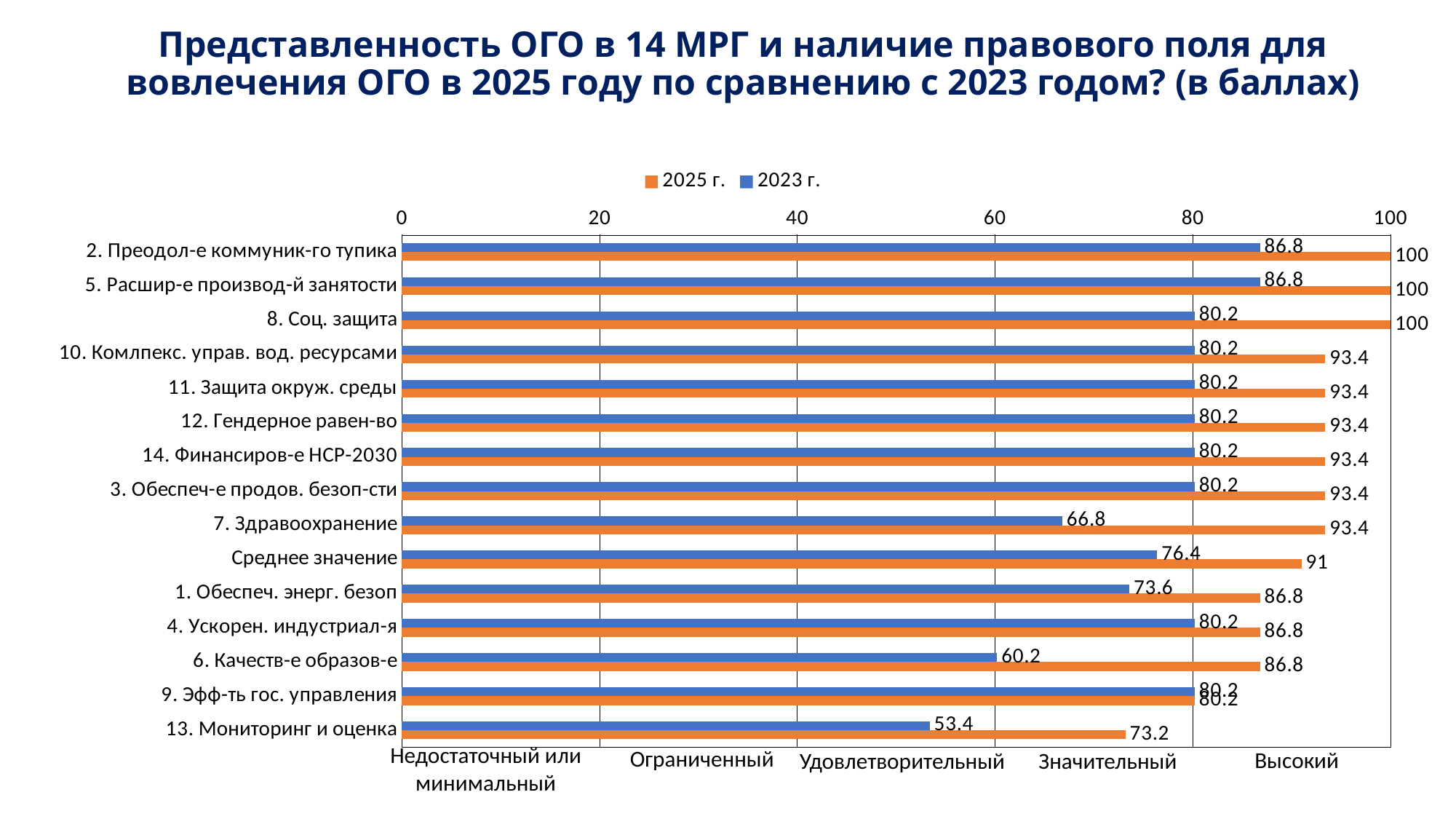
How many categories are plotted on the chart? 15 What is the value for 2023 г. for "13. Мониторинг и оценка"? 53.4 Which colour represents the 2025 г. series in the legend? Orange What is the value for 2025 г. for "7. Здравоохранение"? 93.4 Which is larger for "1. Обеспеч. энерг. безоп": the 2025 г. value or the 2023 г. value? 2025 г. What kind of chart is shown on the slide? Bar chart Which category has the lowest value for 2025 г.? 13. Мониторинг и оценка What is the value for 2023 г. for "Среднее значение"? 76.4 What is the difference between the 2025 г. and 2023 г. values for "13. Мониторинг и оценка"? 19.8 What is the difference between the 2025 г. and 2023 г. values for "6. Качеств-е образов-е"? 26.6 How many series does the legend list? 2 Which category has the lowest value for 2023 г.? 13. Мониторинг и оценка